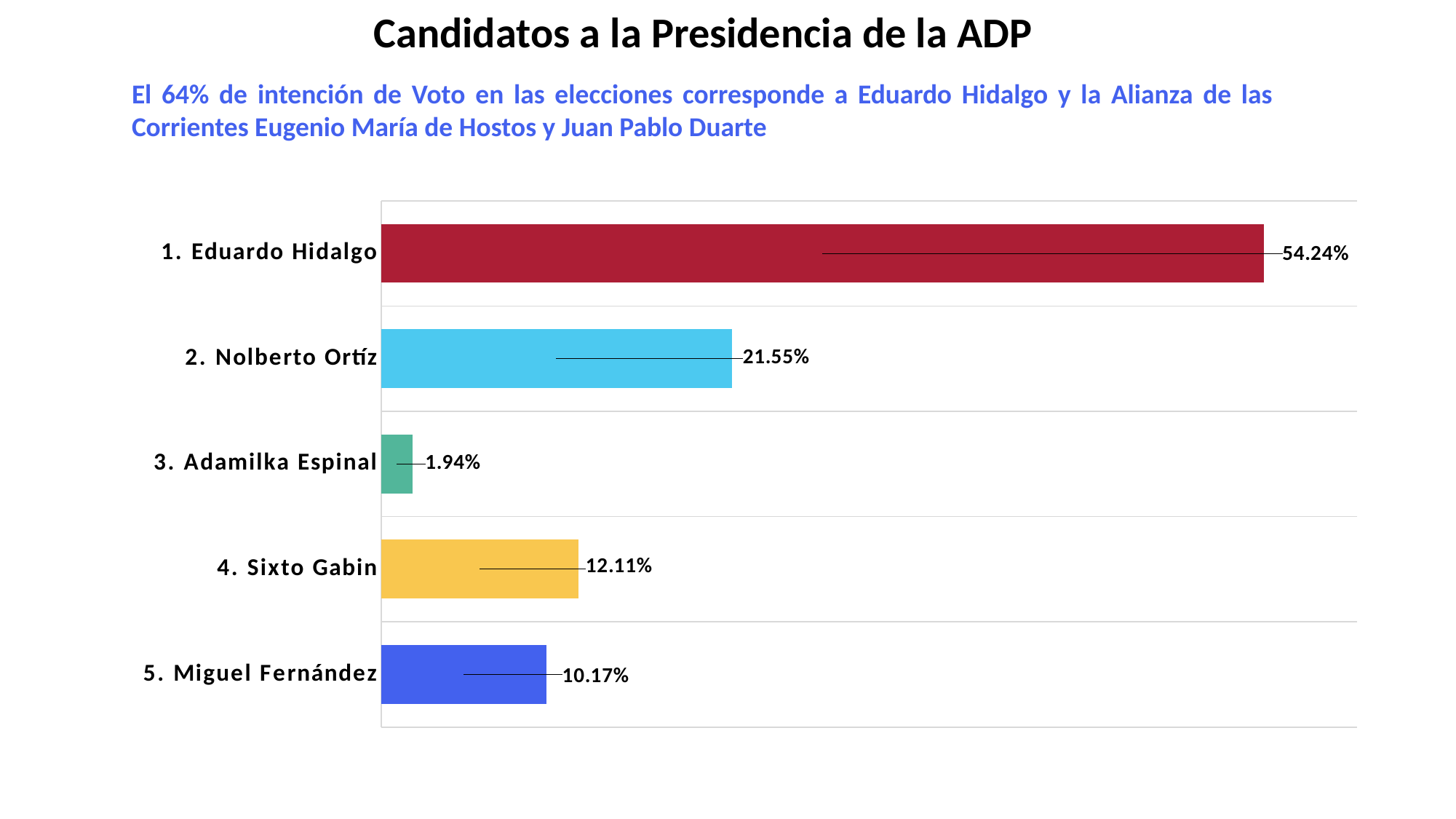
What is the value for 4. Sixto Gabin? 12.11% Which candidate has the lowest value? 3. Adamilka Espinal What is the value for 3. Adamilka Espinal? 1.94% What is the value for 1. Eduardo Hidalgo? 54.24% What is the title of the slide? Candidatos a la Presidencia de la ADP Which is larger, the value for 4. Sixto Gabin or 5. Miguel Fernández? 4. Sixto Gabin What is the difference between the values for 1. Eduardo Hidalgo and 2. Nolberto Ortíz? 32.69% What kind of chart is shown on the slide? Bar chart Which candidate has the highest value? 1. Eduardo Hidalgo What is the value for 5. Miguel Fernández? 10.17% How many candidates are shown in the chart? 5 What is the value for 2. Nolberto Ortíz? 21.55%